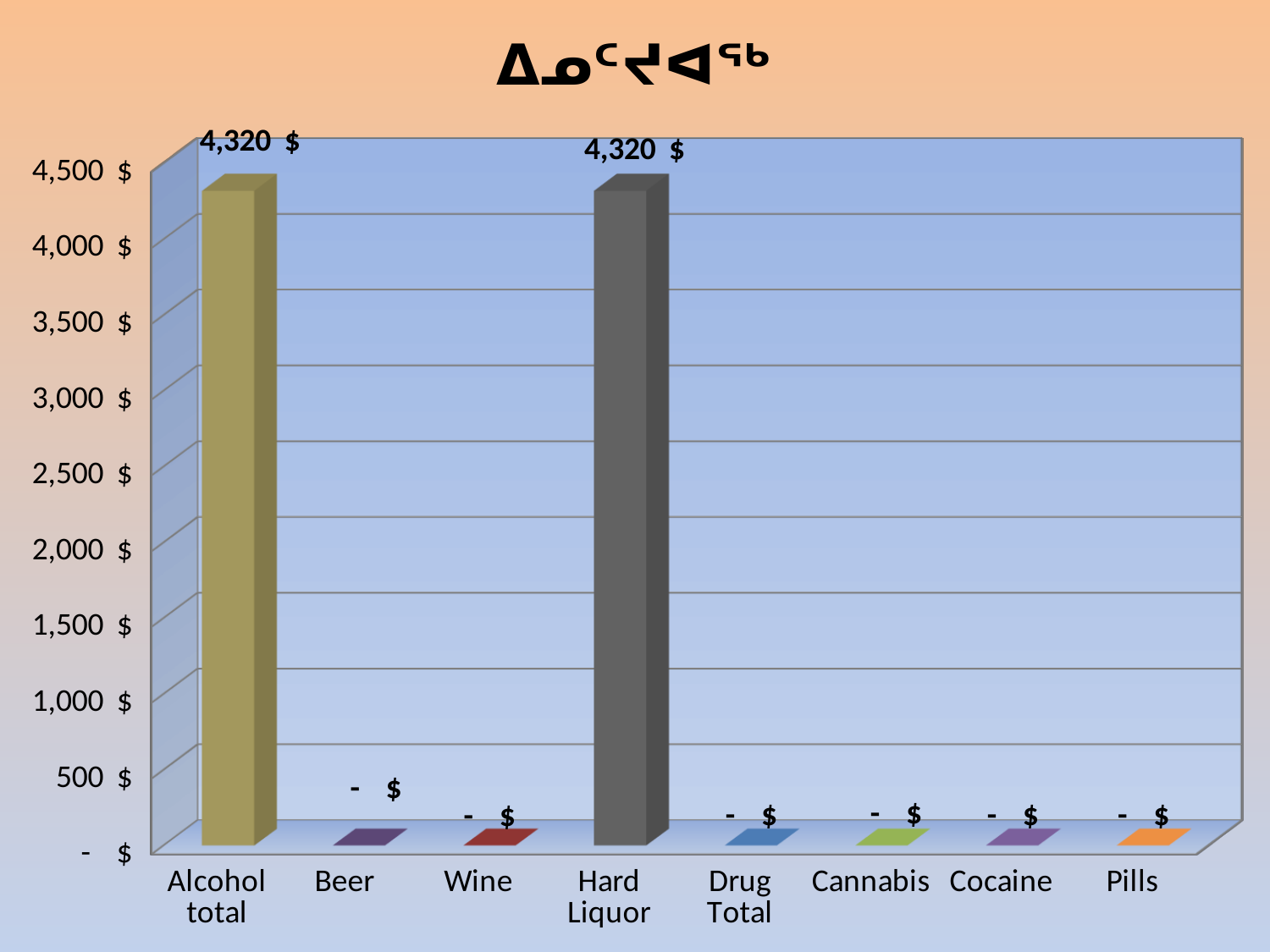
Which two categories share the highest value on the chart? Alcohol total and Hard Liquor What is the value shown for Hard Liquor? 4,320 $ Which is larger, the value for Alcohol total or the value for Beer? Alcohol total What kind of chart is shown on the slide? bar chart How many categories are shown on the x axis? 8 What data label is shown above the Beer bar? - $ What data label is shown above the Drug Total bar? - $ How many categories have a value of 4,320 $? 2 What is the value shown for Alcohol total? 4,320 $ Which is larger, the value for Hard Liquor or the value for Cannabis? Hard Liquor What colour is the Hard Liquor bar? dark grey Is the value for Hard Liquor greater or less than 4,000 $? greater